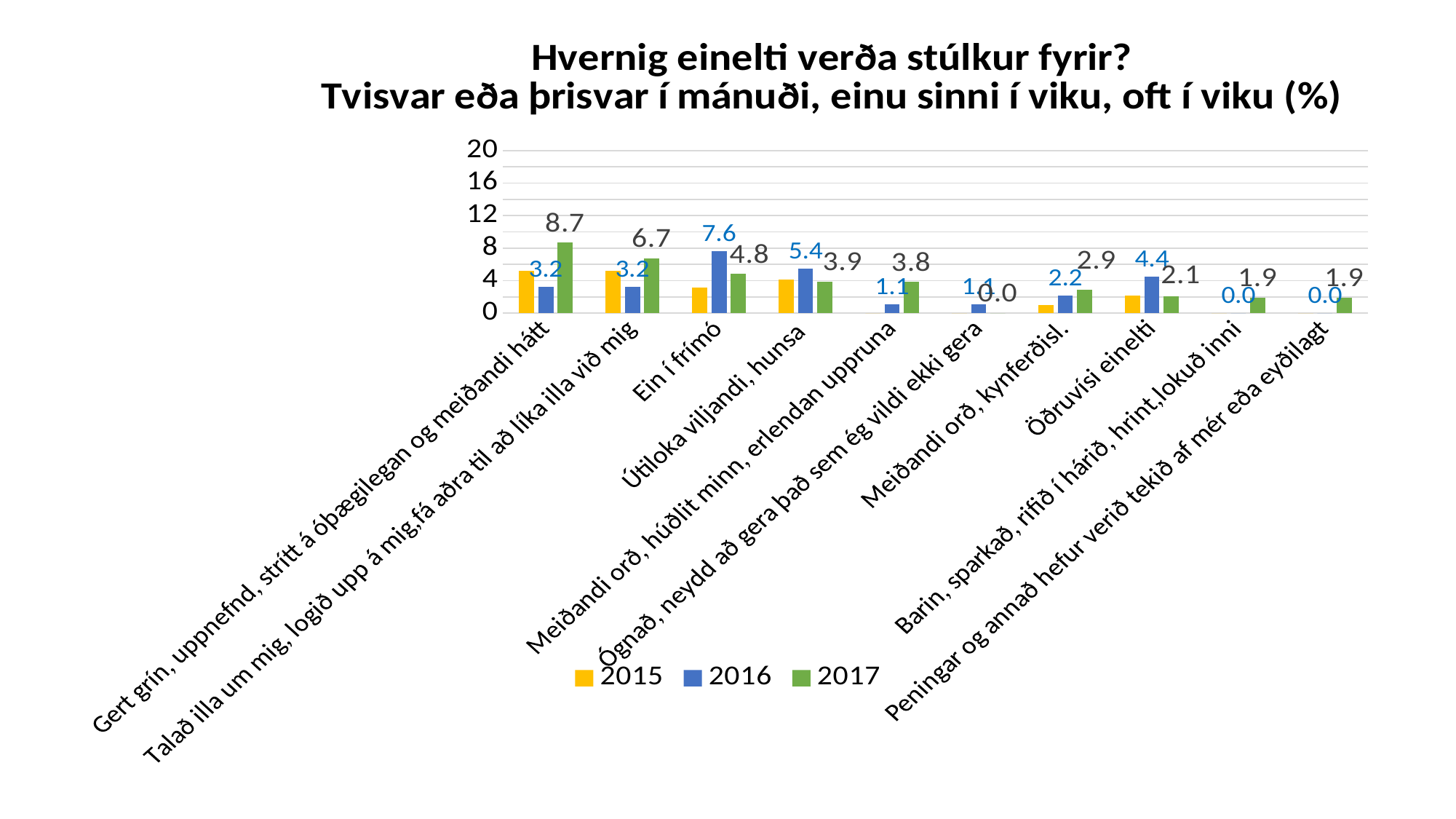
What is the 2017 value for "Öðruvísi einelti"? 2.1 What is the 2016 value for "Útiloka viljandi, hunsa"? 5.4 Which colour represents the 2017 series in the legend? green What is the 2017 value for "Ein í frímó"? 4.8 Which category has the highest 2017 value? Gert grín, uppnefnd, strítt á óþægilegan og meiðandi hátt How many series does the legend list? 3 Which category has the highest 2016 value? Ein í frímó Is the 2015 value for "Gert grín, uppnefnd, strítt á óþægilegan og meiðandi hátt" greater or less than 4? greater What is the difference between the 2017 and 2016 values for "Gert grín, uppnefnd, strítt á óþægilegan og meiðandi hátt"? 5.5 How many categories are shown on the x axis? 10 Which is larger for "Ein í frímó": the 2016 value or the 2017 value? 2016 What kind of chart is shown on the slide? bar chart